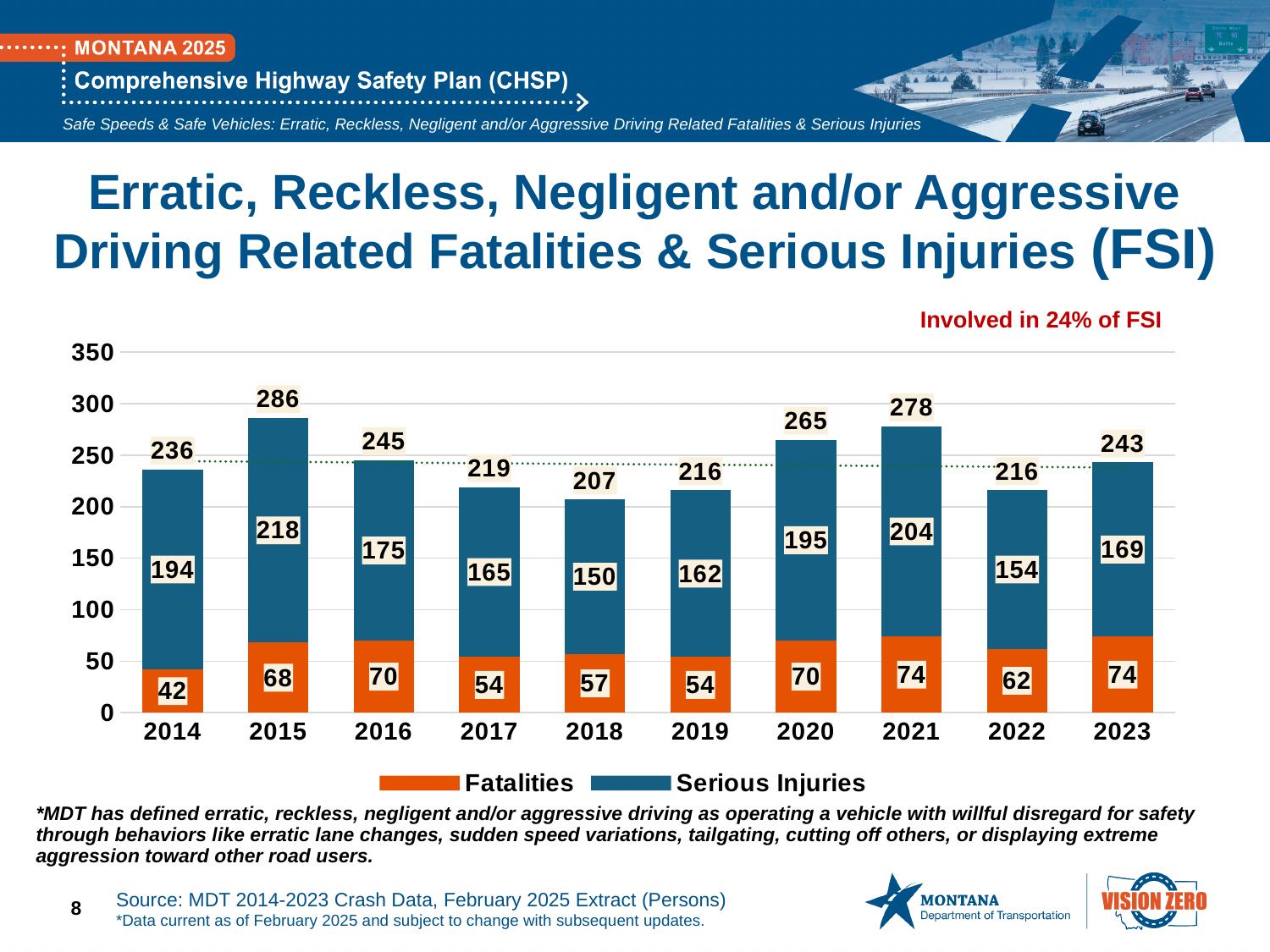
How many years are shown on the x axis? 10 What kind of chart is shown on the slide? Stacked bar chart What is the total FSI value shown above the stacked bar for 2015? 286 Which is larger, the Fatalities value in 2020 or in 2022? 2020 According to the text above the chart, what percentage of FSI involved erratic, reckless, negligent and/or aggressive driving? 24% What is the difference between Serious Injuries in 2015 and in 2018? 68 How many series does the legend list? 2 Which year has the highest total FSI? 2015 Which year has the lowest number of Fatalities? 2014 What is the number of Fatalities in 2014? 42 Which year has the lowest total FSI? 2018 What is the number of Serious Injuries in 2021? 204